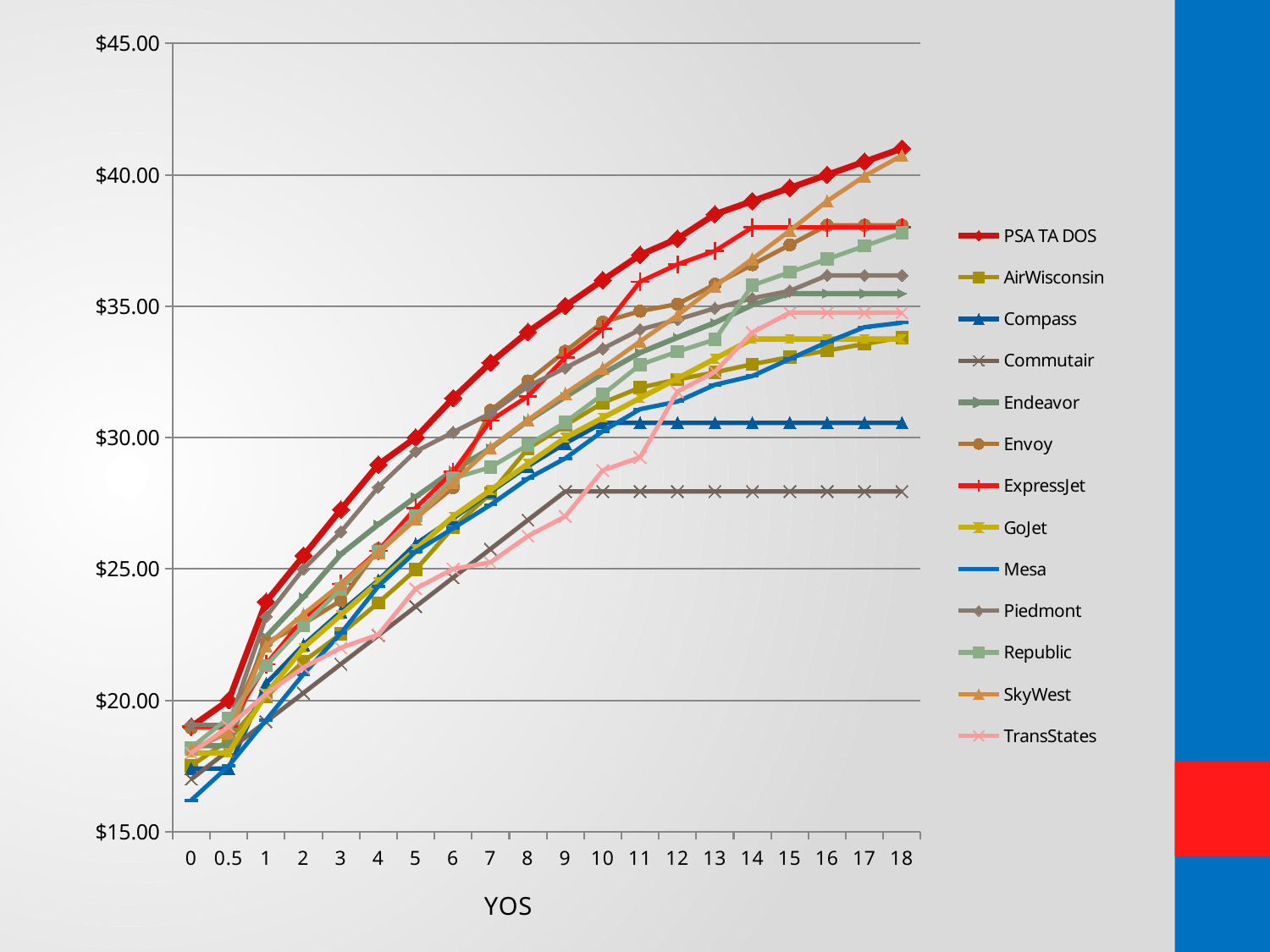
Which series has the highest value at YOS 18? PSA TA DOS How many YOS points are marked along the x axis? 20 At YOS 18, which is larger, Mesa or Compass? Mesa Is the value for PSA TA DOS at YOS 18 greater or less than $40.00? greater How many series does the legend list? 13 Is the value for Mesa at YOS 0 greater or less than $20.00? less At YOS 18, which is larger, SkyWest or ExpressJet? SkyWest Which series has the lowest value at YOS 0? Mesa Which series has the lowest value at YOS 18? Commutair What kind of chart is shown on the slide? line chart Is the value for Commutair at YOS 18 greater or less than $30.00? less What is the title of the x axis? YOS